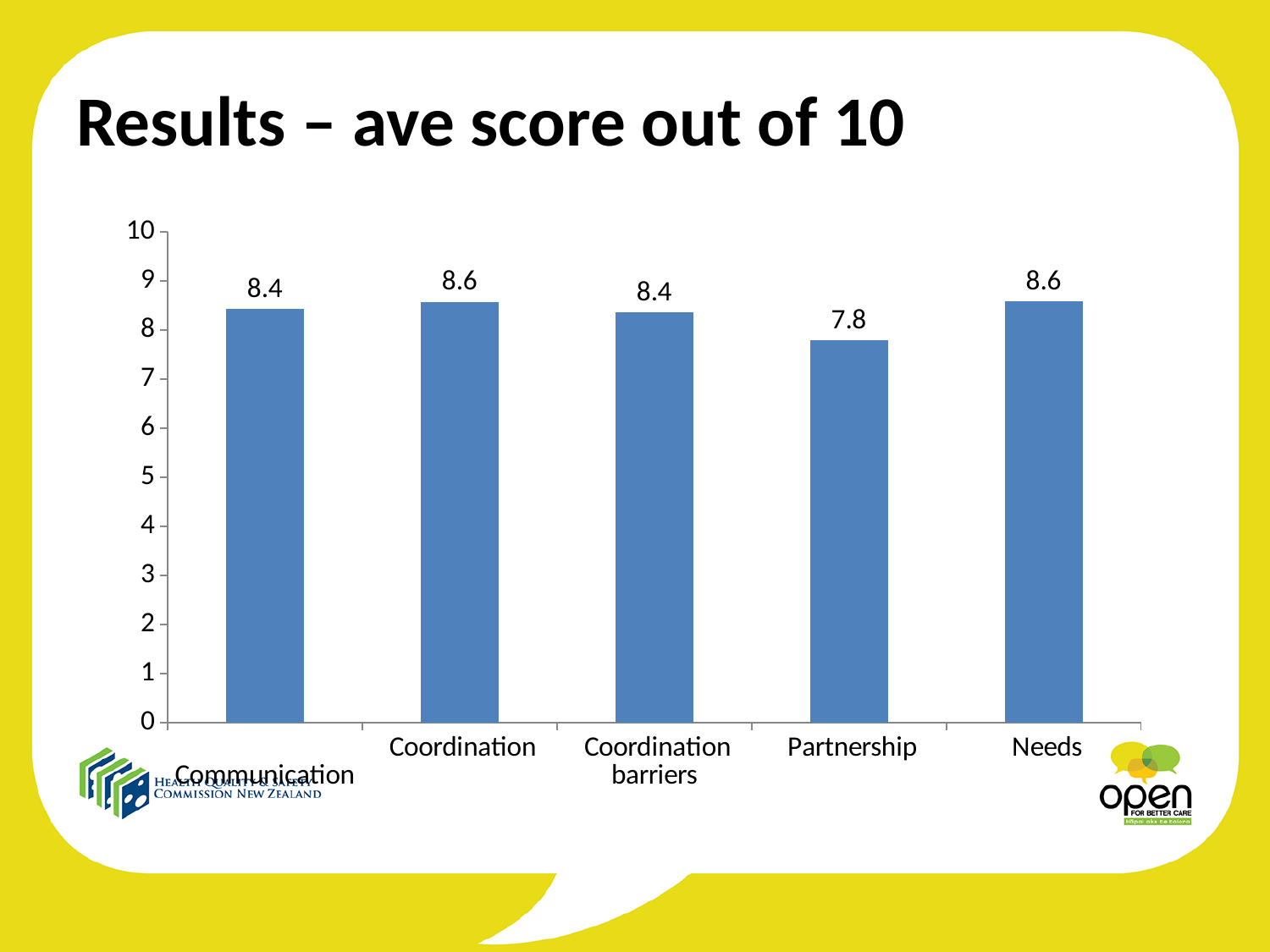
Is the value for Partnership greater or less than 8? less How many categories are shown on the chart? 5 What is the average score for Partnership? 7.8 What is the average score for Communication? 8.4 What is the difference between the scores for Coordination and Partnership? 0.8 What is the average score for Needs? 8.6 What is the title of the slide? Results – ave score out of 10 What kind of chart is shown on the slide? Bar chart Which is larger, the score for Coordination or the score for Partnership? Coordination Which category has the lowest average score? Partnership What is the difference between the scores for Needs and Communication? 0.2 What is the average score for Coordination barriers? 8.4